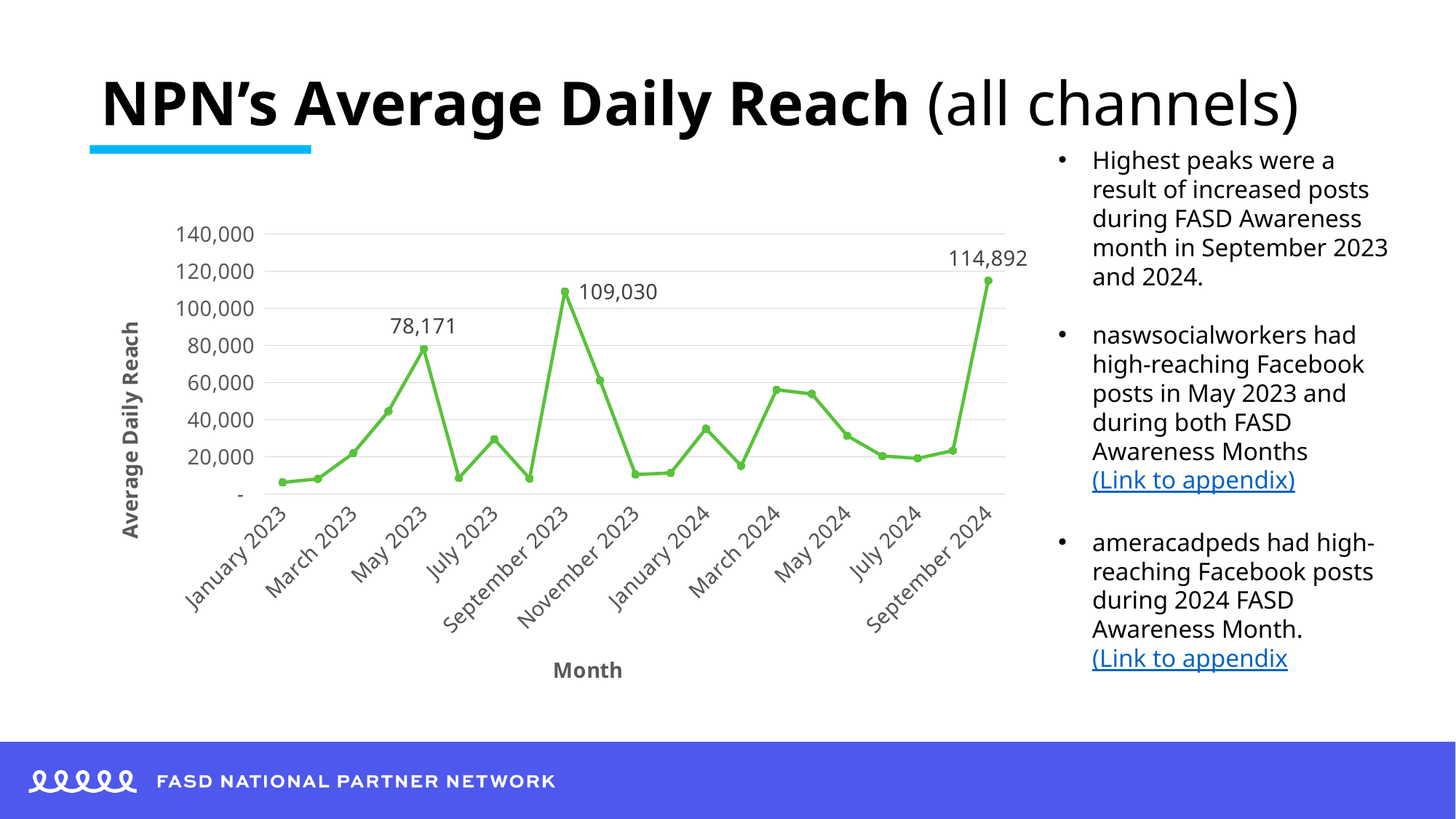
What kind of chart is shown on the slide? line chart Which is larger, the average daily reach in September 2023 or in May 2023? September 2023 Is the value for March 2024 greater or less than 40,000? greater What is the average daily reach for May 2023? 78,171 What is the average daily reach for September 2023? 109,030 What is the difference between the average daily reach in September 2023 and May 2023? 30,859 Is the value for January 2023 greater or less than 20,000? less What is the average daily reach for September 2024? 114,892 What is the difference between the average daily reach in September 2024 and September 2023? 5,862 How many monthly data points are plotted on the chart? 21 Which month has the highest average daily reach? September 2024 What is the title of the vertical axis? Average Daily Reach